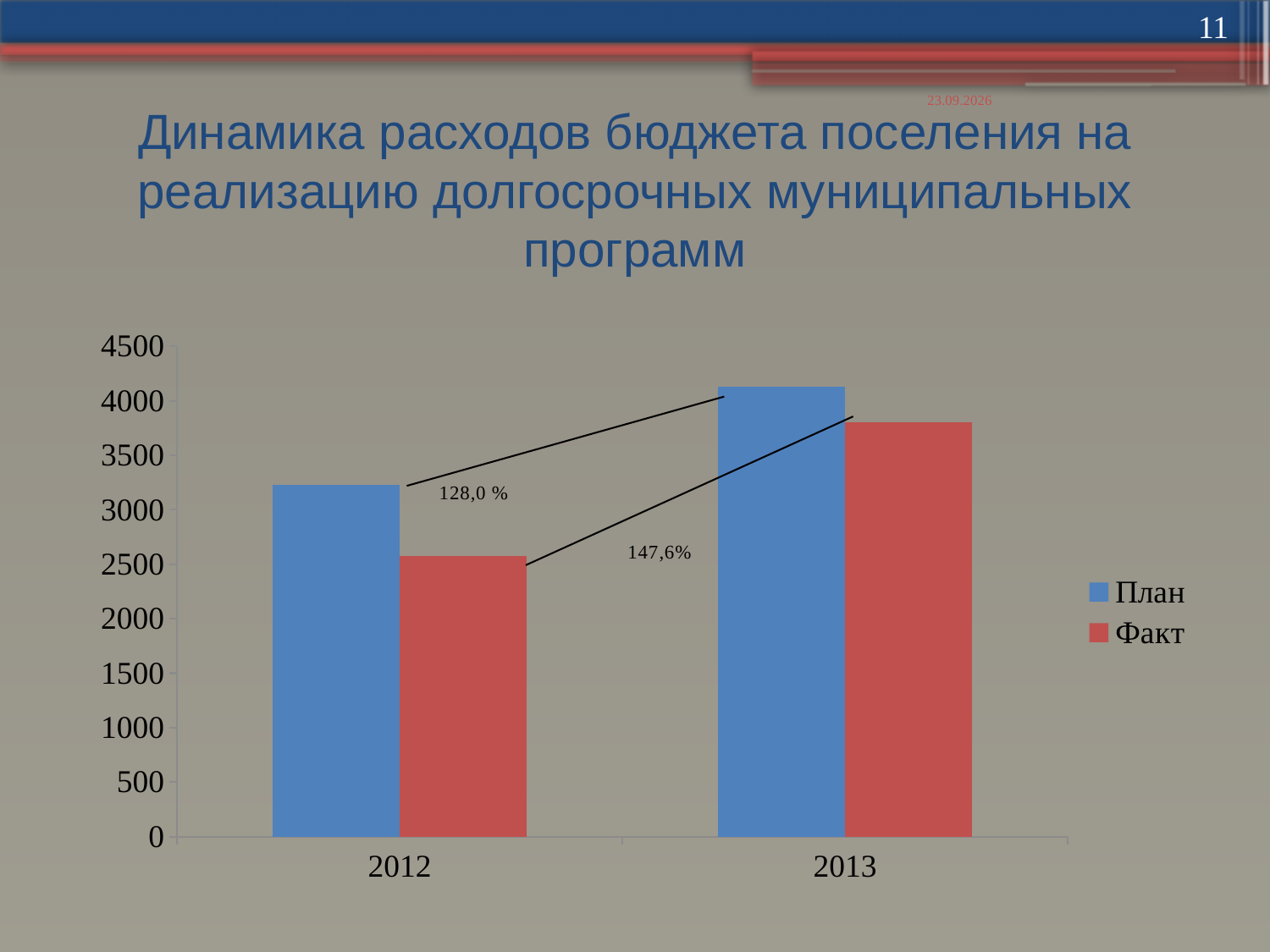
Which bar is the highest on the chart? План for 2013 Which bar is the lowest on the chart? Факт for 2012 How many series does the legend list? 2 Is the value for Факт in 2013 greater or less than 4000? less What kind of chart is shown on the slide? bar chart In 2013, which is larger, План or Факт? План Is the value for Факт in 2012 greater or less than 3000? less Do the Факт values rise or fall from 2012 to 2013? rise What percentage label is printed next to the line connecting the two План bars? 128,0 % In 2012, which is larger, План or Факт? План How many year categories are shown on the x axis? 2 Is the value for План in 2012 greater or less than 3000? greater